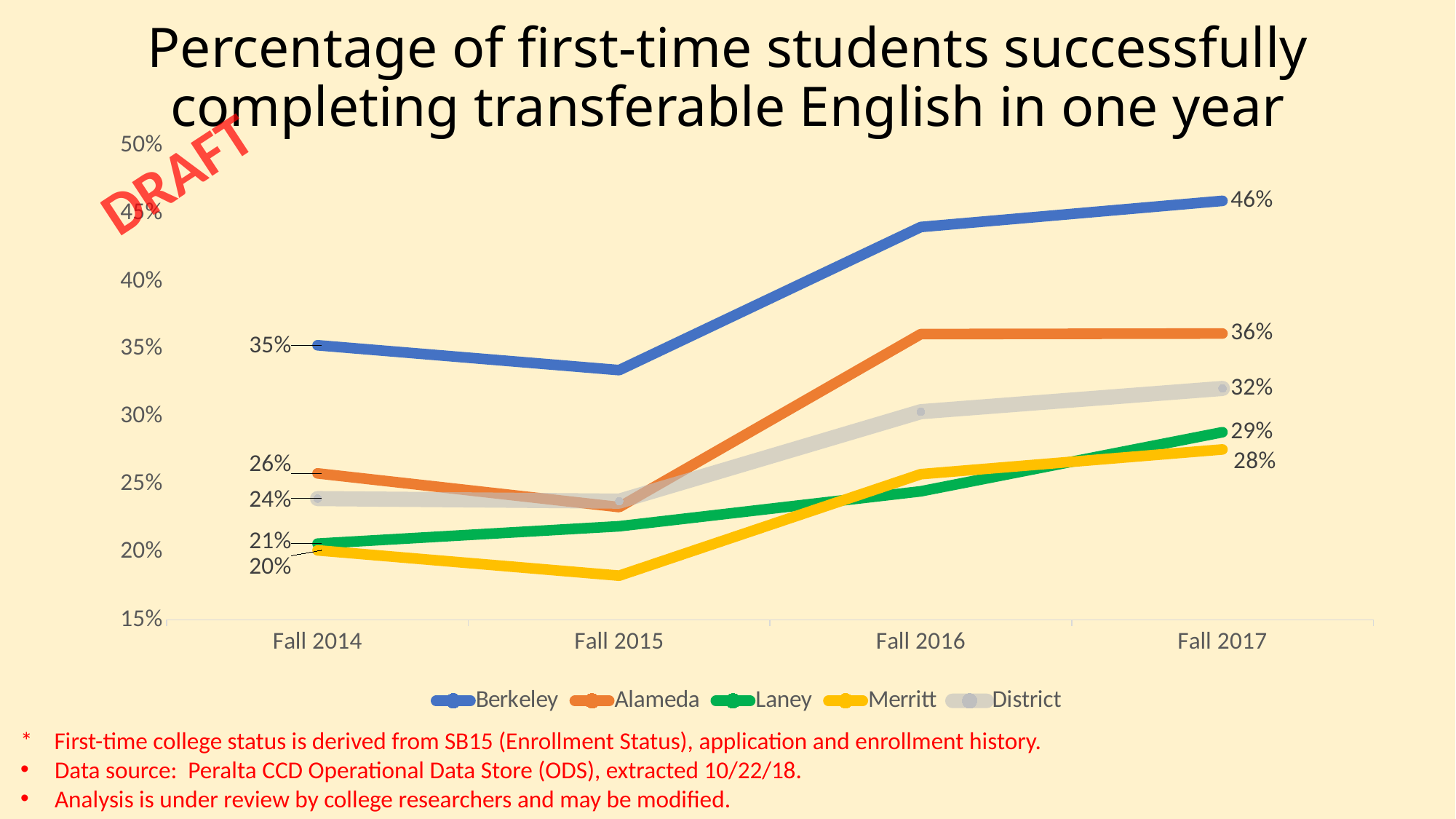
How many time points are shown on the x axis? 4 How many series does the legend list? 5 What is the value for Merritt in Fall 2014? 20% Which college or series has the highest value in Fall 2017? Berkeley In Fall 2017, which is larger: the value for Alameda or the value for District? Alameda What is the value for District in Fall 2017? 32% Is the value for Merritt in Fall 2015 greater or less than 20%? less By how many percentage points did Berkeley's value change from Fall 2014 to Fall 2017? 11 percentage points What is the value for Berkeley in Fall 2017? 46% Is the value for Berkeley in Fall 2016 greater or less than 40%? greater What kind of chart is shown on the slide? Line chart Which college or series has the lowest value in Fall 2014? Merritt